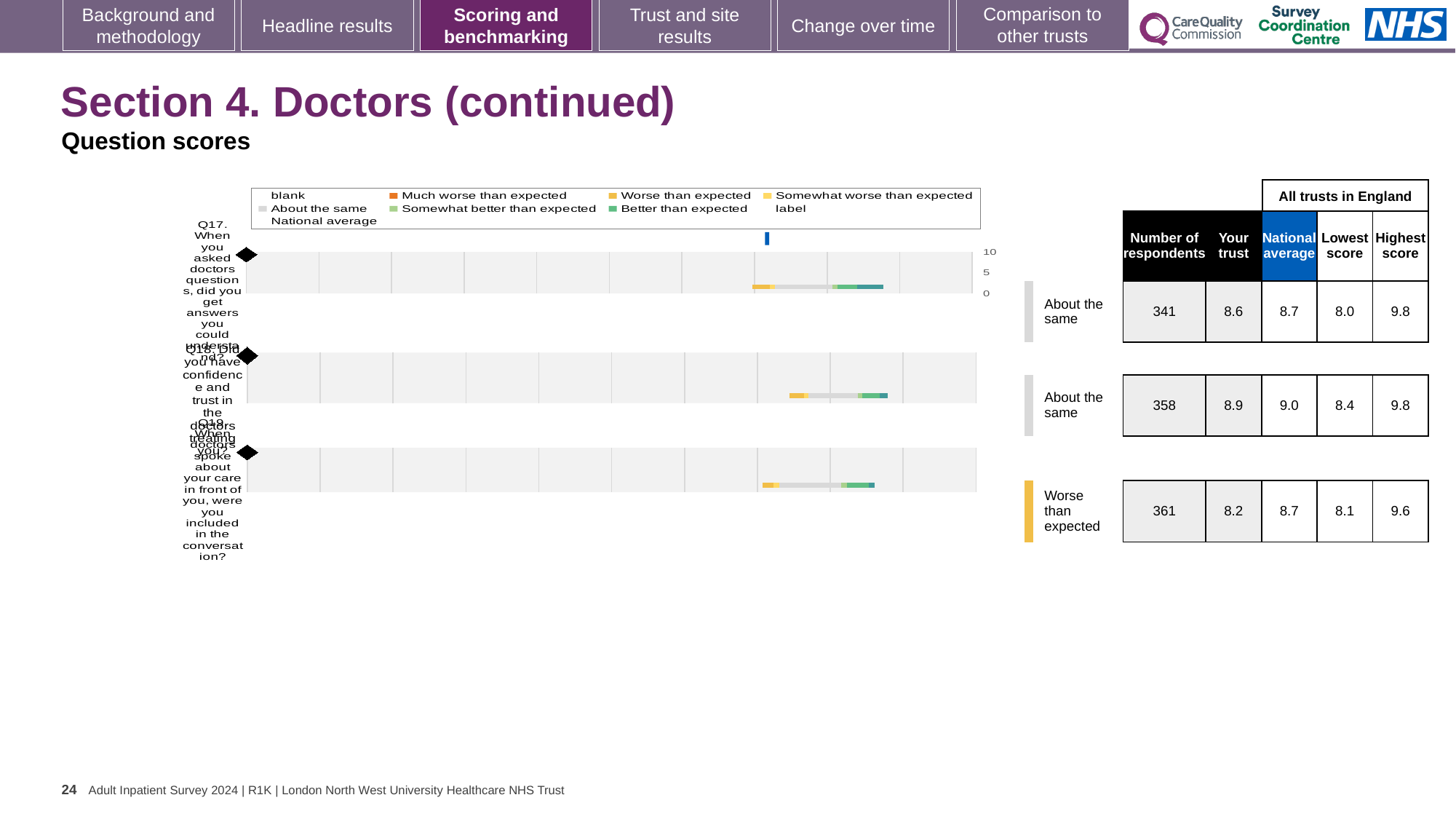
Which question has the highest 'Your trust' score? Q18 In the table beside the chart, what is the national average for Q19? 8.7 In the table beside the chart, what is the 'Your trust' score for Q18? 8.9 For Q19, which is larger: the 'Your trust' score or the national average? National average What kind of chart is shown on the slide? bar chart What benchmark category is shown for Q19? Worse than expected What colour does the legend use for 'Much worse than expected'? orange Which question has the lowest 'Your trust' score? Q19 What is the highest value shown on the chart's score axis? 10 How many questions (categories) are plotted in the chart? 3 In the table beside the chart, how many respondents are listed for Q17? 341 For Q18, what is the difference between the highest score and the lowest score in the table? 1.4